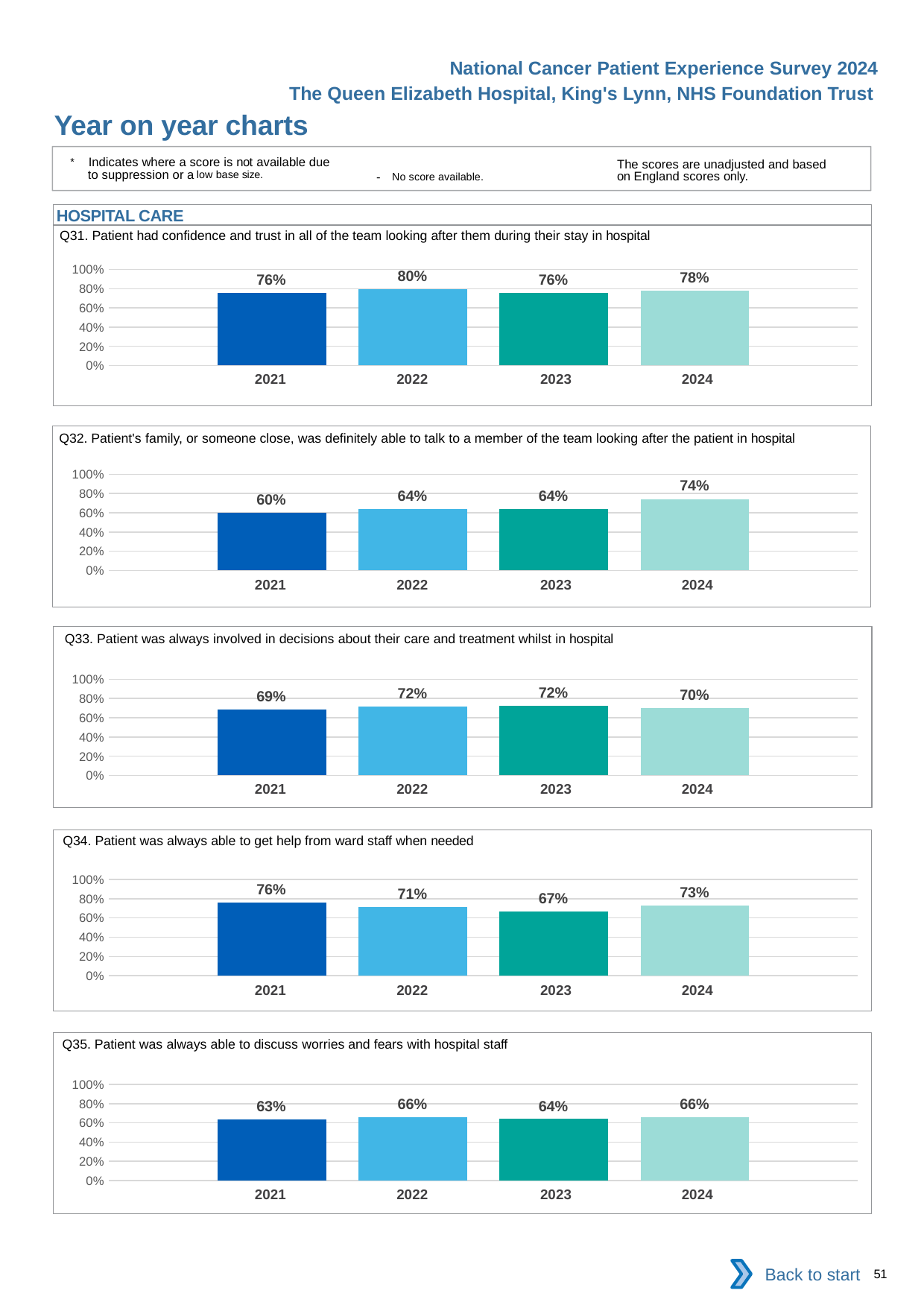
How many years are shown in the Q31 chart? 4 What kind of chart is the Q33 chart? Bar chart In the Q32 chart, which year has the highest value? 2024 In the Q33 chart, what is the value for 2021? 69% In the Q34 chart, which is larger, the value for 2021 or the value for 2024? 2021 In the Q34 chart, which year has the lowest value? 2023 In the Q32 chart, what is the difference between the 2024 and 2021 values? 14% How many charts are shown on the slide? 5 In the Q34 chart, is the value for 2023 greater or less than 80%? less In the Q35 chart, what is the difference between the 2022 and 2021 values? 3% In the Q31 chart, what is the value for 2022? 80% In the Q35 chart, what is the value for 2023? 64%